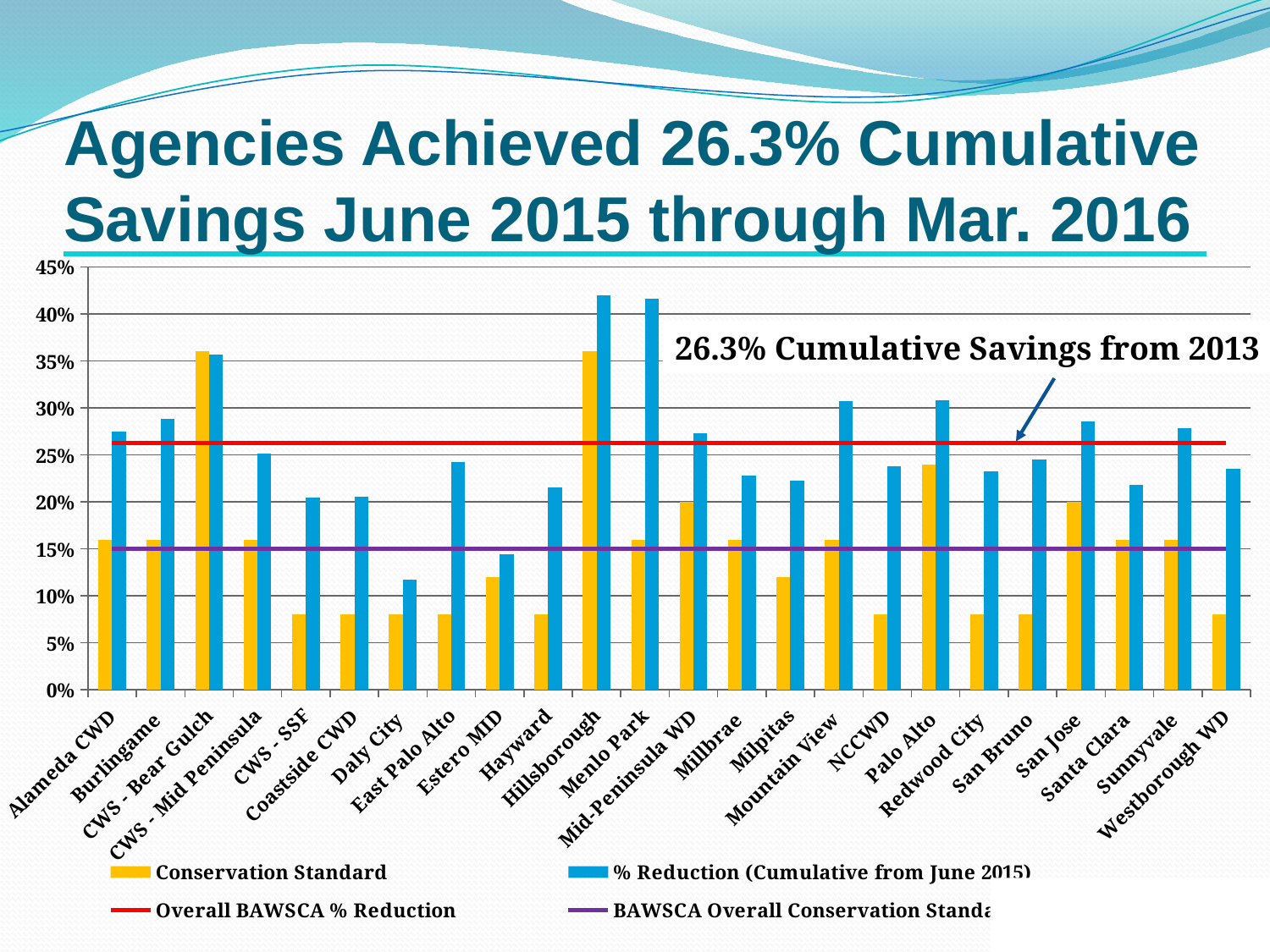
What overall cumulative savings percentage does the red line (Overall BAWSCA % Reduction) represent? 26.3% What kind of chart is shown on the slide? combination bar and line chart Is the % Reduction (Cumulative from June 2015) for Burlingame greater or less than 25%? greater How many series does the legend list? 4 What does the purple horizontal line represent according to the legend? BAWSCA Overall Conservation Standard How many agencies (categories) are shown along the x axis? 24 Which has the larger Conservation Standard: CWS - Bear Gulch or Alameda CWD? CWS - Bear Gulch Is the % Reduction (Cumulative from June 2015) for Hillsborough greater or less than 40%? greater Which agency has the lowest % Reduction (Cumulative from June 2015)? Daly City Is the Conservation Standard for CWS - Bear Gulch greater or less than 30%? greater Which has the larger % Reduction (Cumulative from June 2015): Hillsborough or Daly City? Hillsborough